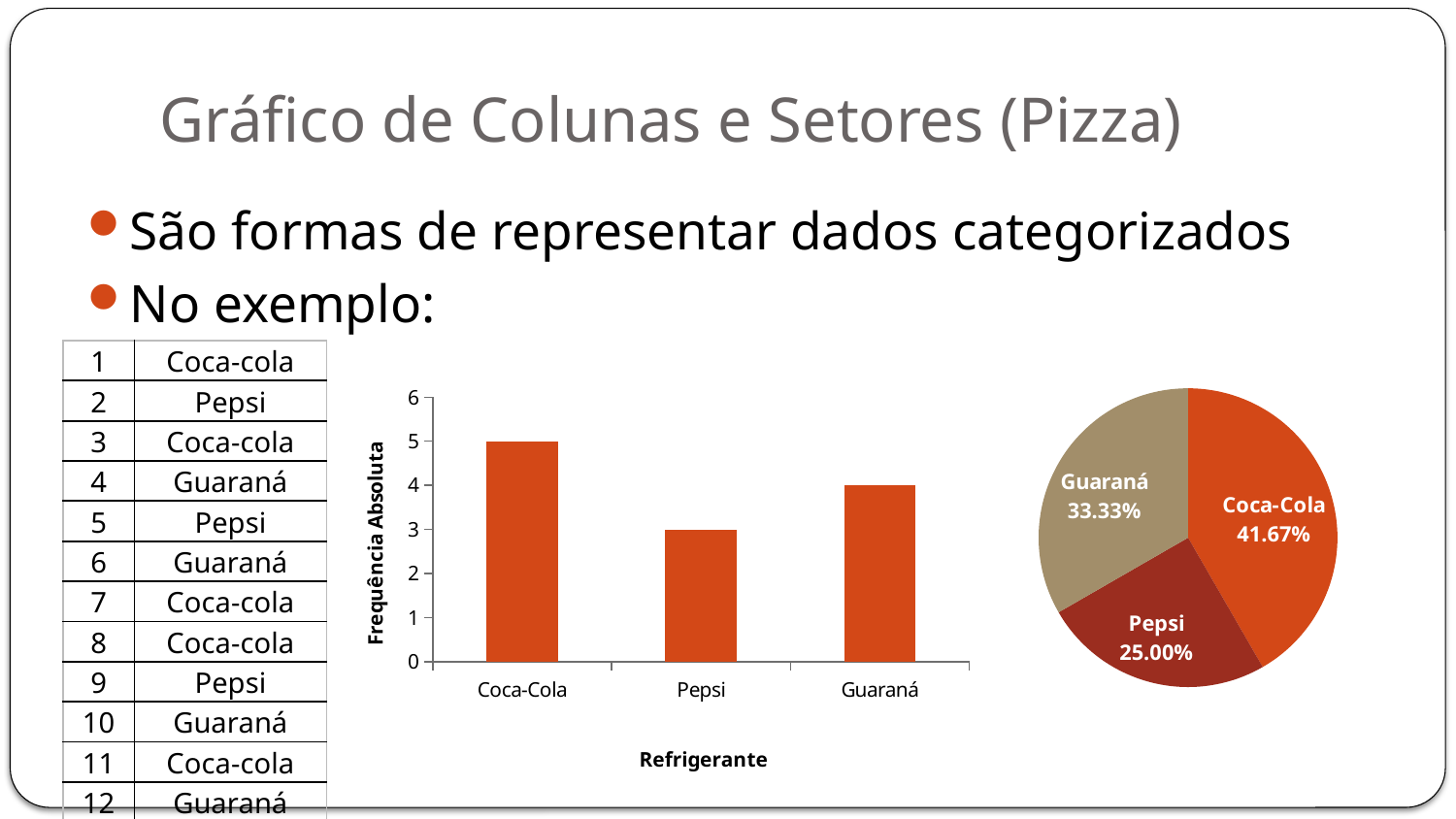
In the bar chart, what is the difference between the Frequência Absoluta of Coca-Cola and Pepsi? 2 In the bar chart, what is the Frequência Absoluta for Guaraná? 4 How many categories are shown on the x axis of the bar chart? 3 In the pie chart, what share does Coca-Cola have? 41.67% In the bar chart, which refrigerante has the lowest Frequência Absoluta? Pepsi In the pie chart, what share does Pepsi have? 25.00% In the bar chart, which refrigerante has the highest Frequência Absoluta? Coca-Cola What kind of chart is the chart on the left with the axis title Refrigerante? Bar chart In the bar chart, what is the Frequência Absoluta for Coca-Cola? 5 In the pie chart, which slice is the largest? Coca-Cola In the bar chart, which is larger, the value for Guaraná or the value for Pepsi? Guaraná In the bar chart, what is the Frequência Absoluta for Pepsi? 3